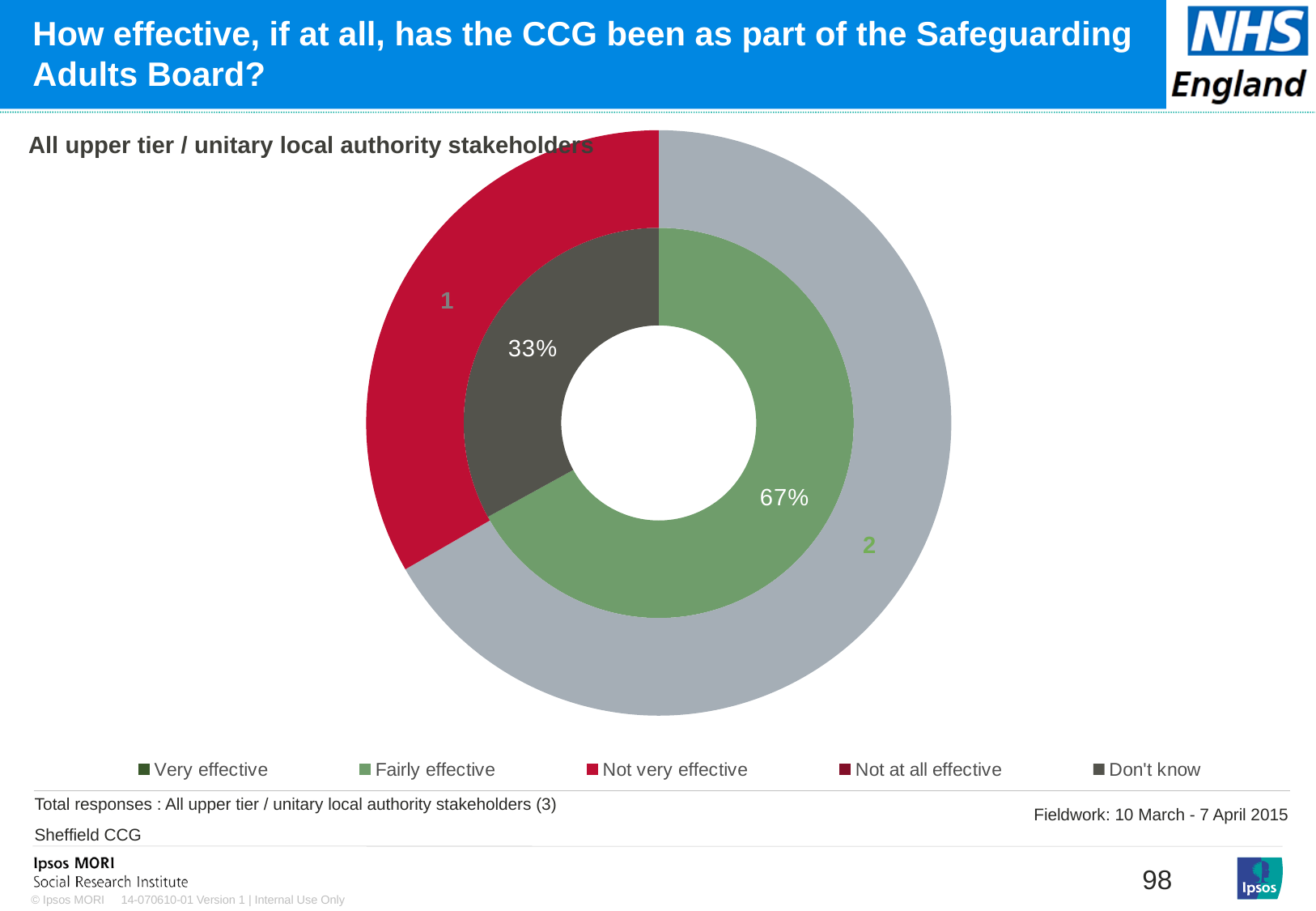
How many percentage labels are printed on the inner ring of the chart? 2 Which inner segment of the doughnut chart is larger, the green one or the dark grey one? The green one (67%) What percentage is shown on the green inner segment of the doughnut chart? 67% What is the title shown above the chart? All upper tier / unitary local authority stakeholders What is the difference in percentage points between the 67% segment and the 33% segment? 34 percentage points Which legend category corresponds to the green colour used for the 67% segment? Fairly effective What number is printed on the red segment of the outer ring? 1 How many categories does the legend of the chart list? 5 What number is printed on the light grey segment of the outer ring? 2 What percentage is shown on the dark grey inner segment of the doughnut chart? 33% What kind of chart is shown on the slide? Pie (doughnut) chart What is the total of the two percentages printed on the inner ring? 100%